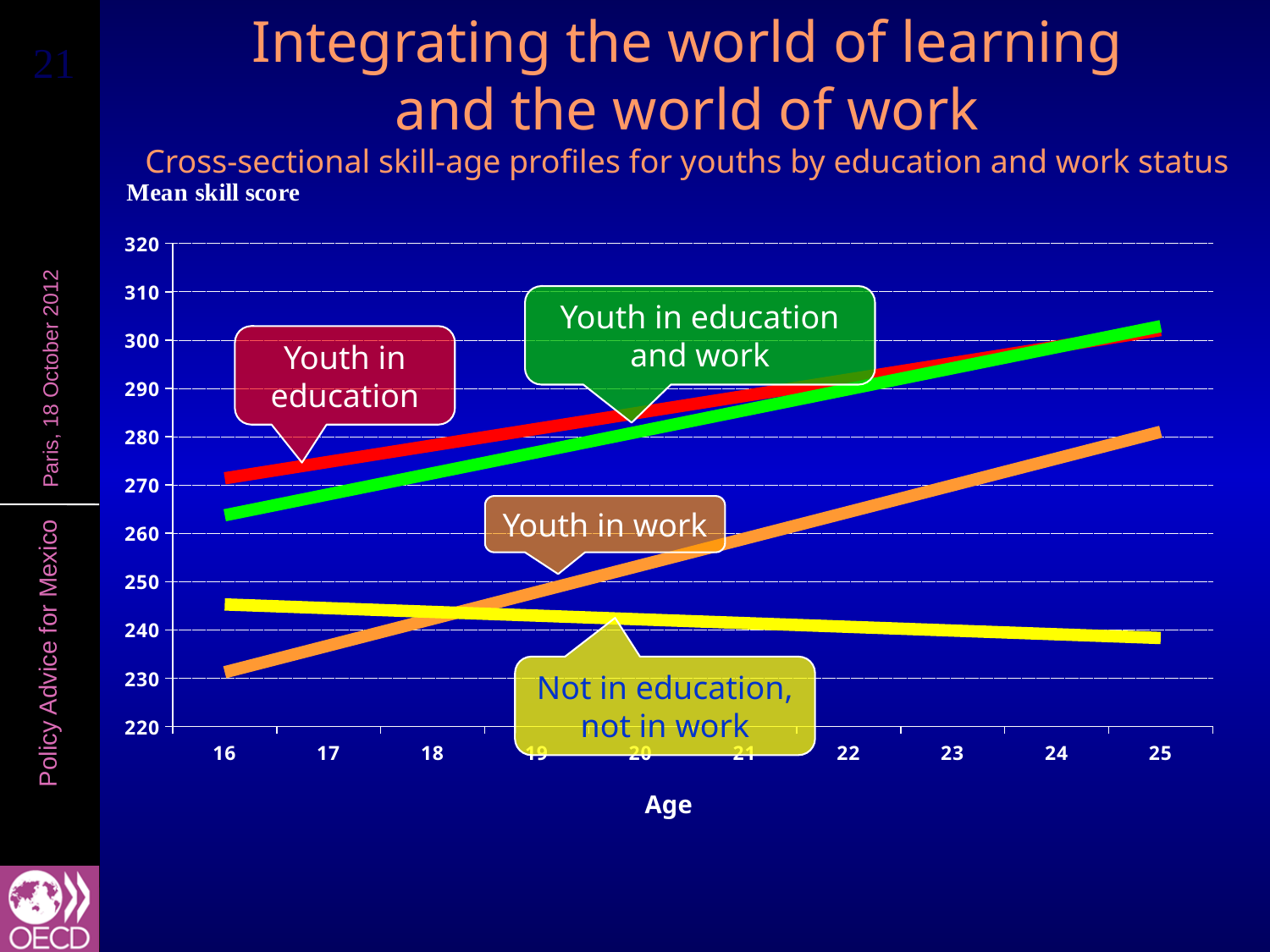
Does the mean skill score for 'Not in education, not in work' rise or fall as age increases? fall What is the label of the x axis? Age Which group has the lowest mean skill score at age 25? Not in education, not in work How many age points are shown along the x axis? 10 Is the mean skill score for 'Youth in work' at age 16 greater or less than 240? less How many series (groups of youths) are plotted on the chart? 4 What kind of chart is shown on the slide? line chart At age 25, which has the higher mean skill score: 'Youth in work' or 'Not in education, not in work'? Youth in work Does the mean skill score for 'Youth in work' rise or fall as age increases? rise Is the mean skill score for 'Youth in education and work' at age 25 greater or less than 290? greater Is the mean skill score for 'Not in education, not in work' at age 25 greater or less than 250? less Which group has the lowest mean skill score at age 16? Youth in work